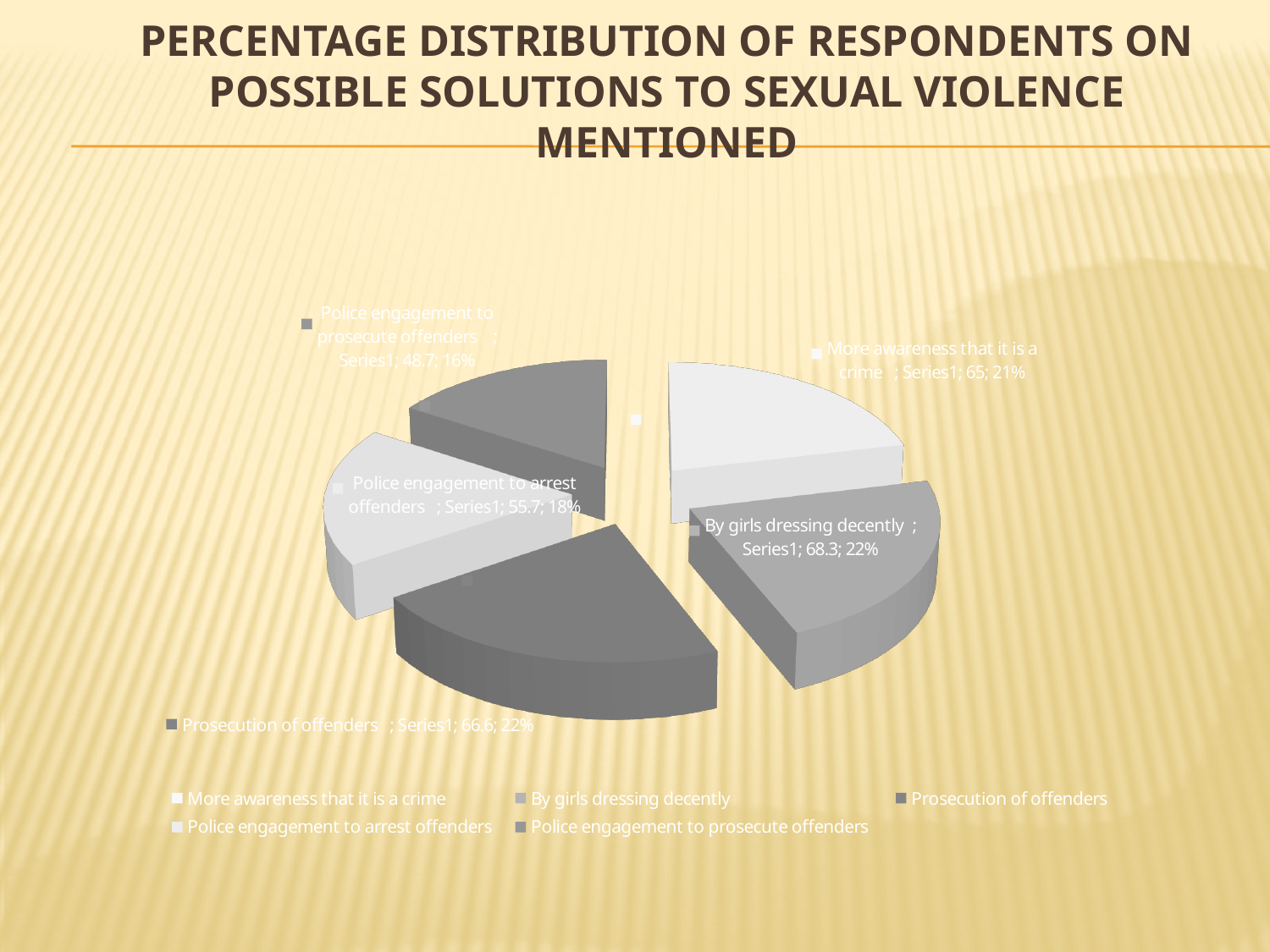
What percentage share is shown for "More awareness that it is a crime"? 21% Which category has the highest value in the pie chart? By girls dressing decently How many slices does the pie chart have? 5 What is the title of the chart on the slide? Percentage distribution of respondents on possible solutions to sexual violence mentioned What value is shown for "Police engagement to arrest offenders"? 55.7 What value is shown for "By girls dressing decently"? 68.3 Which category has the lowest value in the pie chart? Police engagement to prosecute offenders What kind of chart is shown on the slide? Pie chart What percentage share is shown for "Prosecution of offenders"? 22% What percentage share is shown for "Police engagement to prosecute offenders"? 16% What is the difference between the values for "Prosecution of offenders" and "Police engagement to arrest offenders"? 10.9 Which is larger, the value for "More awareness that it is a crime" or the value for "Police engagement to prosecute offenders"? More awareness that it is a crime